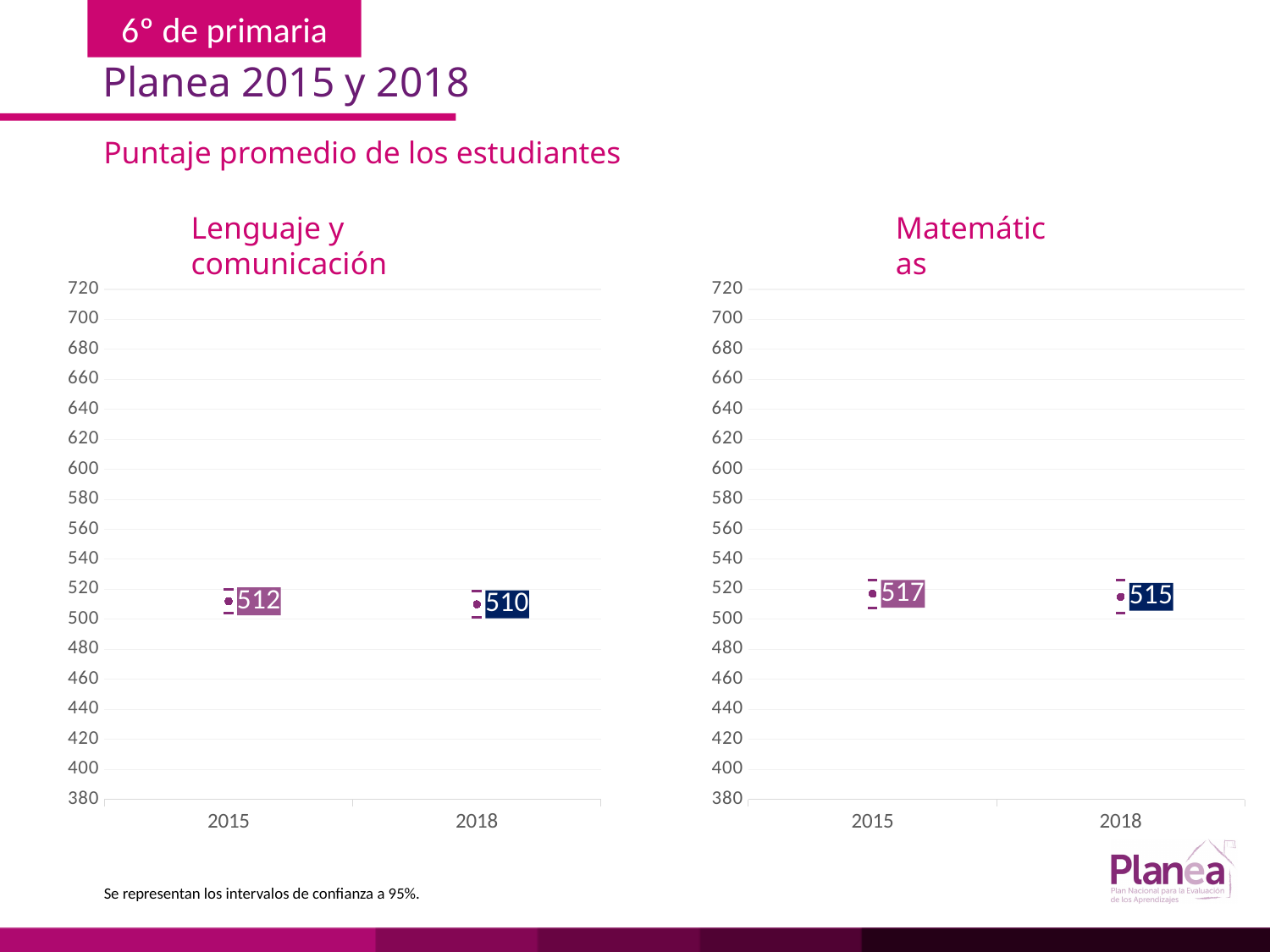
In the Matemáticas chart, what is the average score for 2015? 517 In the Lenguaje y comunicación chart, do the scores rise or fall from 2015 to 2018? fall In the Lenguaje y comunicación chart, by how many points did the average score change from 2015 to 2018? 2 In the Matemáticas chart, what is the difference between the 2015 and 2018 scores? 2 How many years are plotted on the x axis of the Lenguaje y comunicación chart? 2 In the Lenguaje y comunicación chart, what is the average score for 2018? 510 What is the lowest value shown on the y axis of the Matemáticas chart? 380 In the Matemáticas chart, is the 2015 score greater or less than 540? less In the Lenguaje y comunicación chart, what is the average score for 2015? 512 In the Matemáticas chart, what is the average score for 2018? 515 In the Matemáticas chart, which year has the higher score, 2015 or 2018? 2015 What is the title of the chart on the right side of the slide? Matemáticas